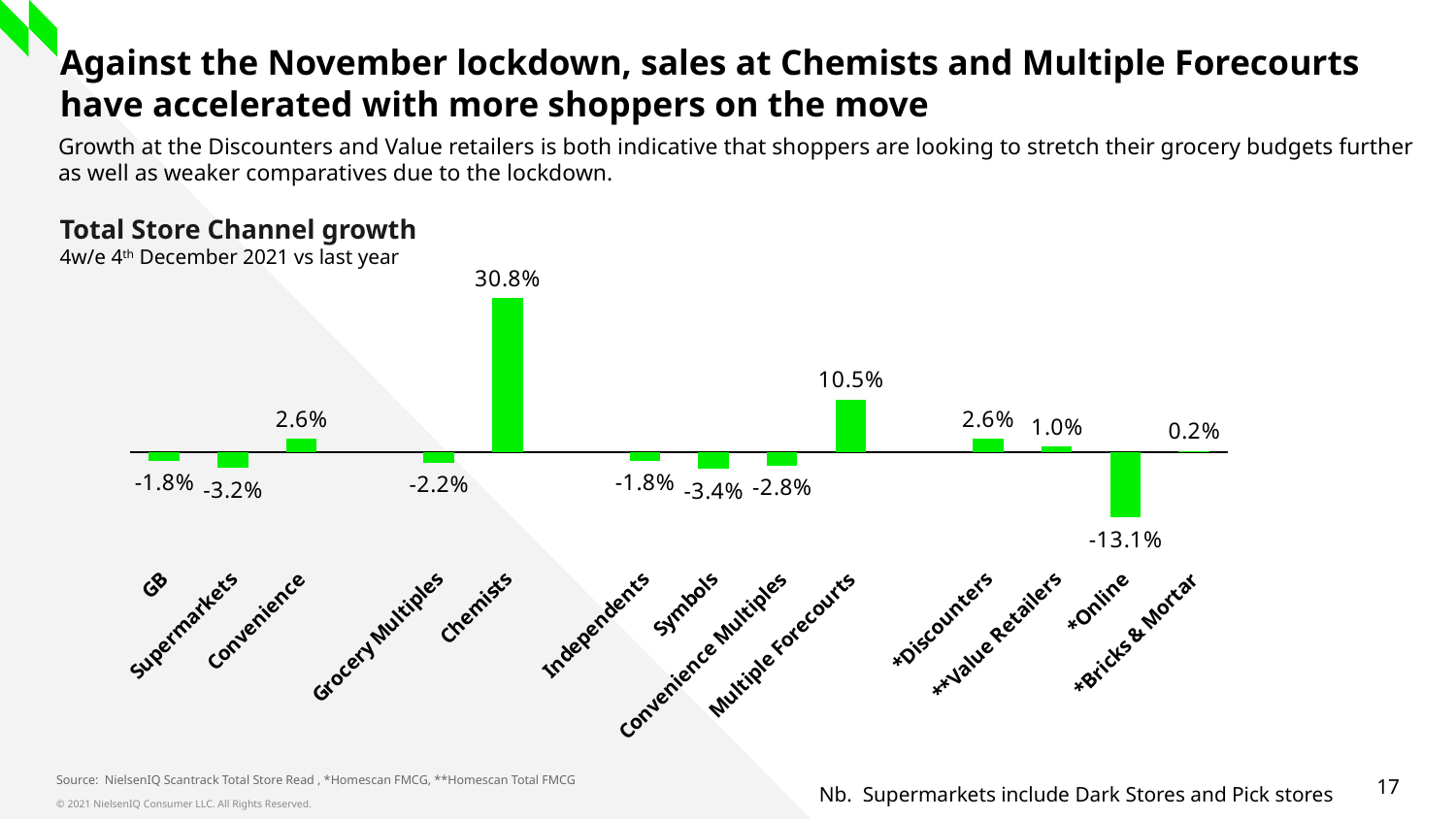
What is the value for Multiple Forecourts? 10.5% What is the value for Supermarkets? -3.2% What kind of chart is shown on the slide? Bar chart What is the value for *Online? -13.1% Which category has the highest value? Chemists What is the value for **Value Retailers? 1.0% What is the value for Chemists? 30.8% What is the title of the chart? Total Store Channel growth How many categories are shown on the chart? 13 What is the difference between the values for Chemists and Multiple Forecourts? 20.3 percentage points Which is larger, the value for Convenience or the value for **Value Retailers? Convenience Which category has the lowest value? *Online